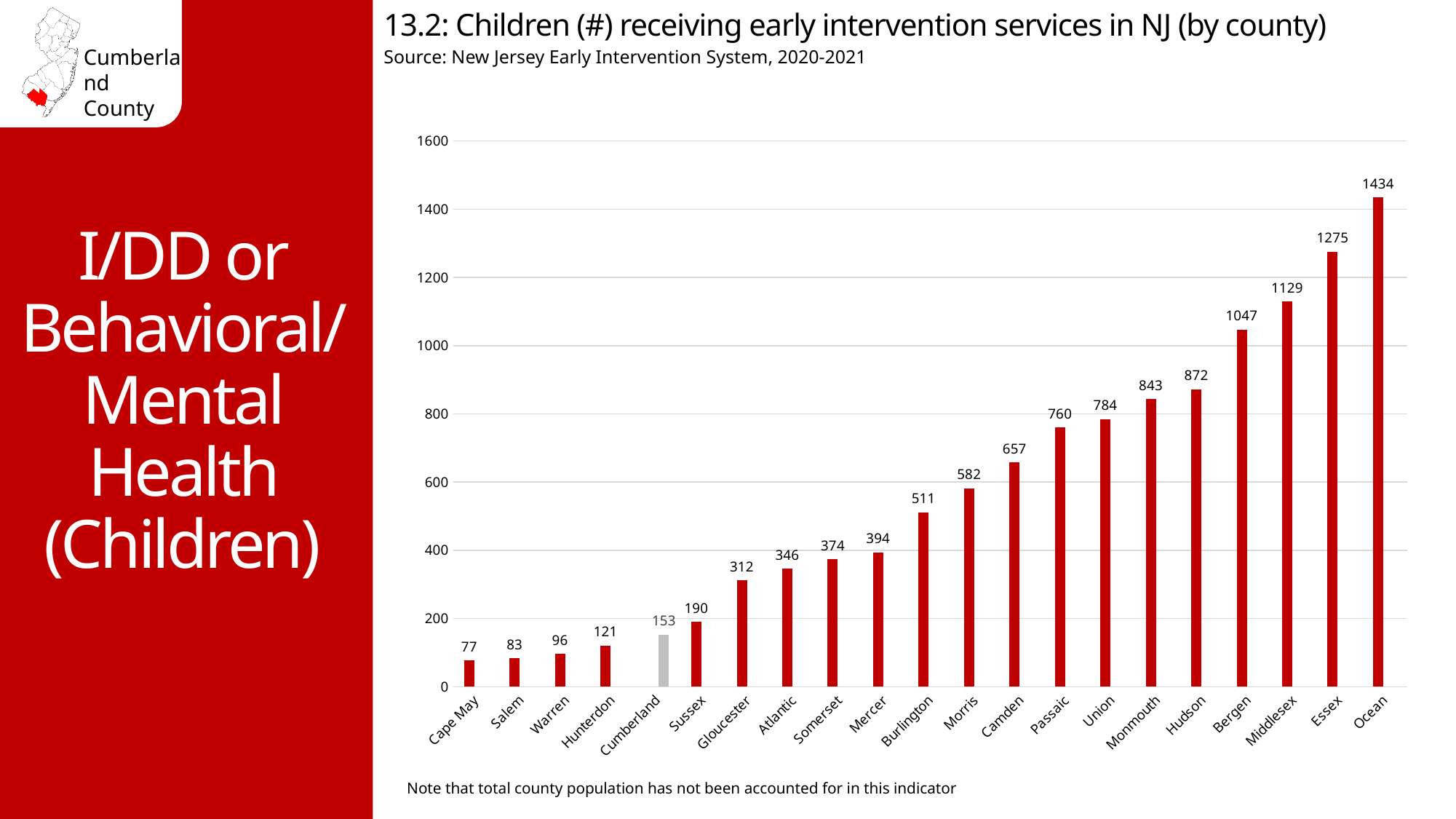
How many counties are shown on the x axis of the chart? 21 Which bar is coloured differently (grey) from the others? Cumberland What kind of chart is shown on the slide? Bar chart What is the difference between the values for Essex and Middlesex? 146 What is the value shown for Ocean County? 1434 Which county has a larger value, Camden or Passaic? Passaic Is the value for Bergen greater or less than 1000? greater What is the difference between the values for Cumberland and Cape May? 76 Which county has the highest number of children receiving early intervention services? Ocean Which county has the lowest number of children receiving early intervention services? Cape May What is the value shown for Mercer County? 394 How many children are receiving early intervention services in Cumberland County? 153